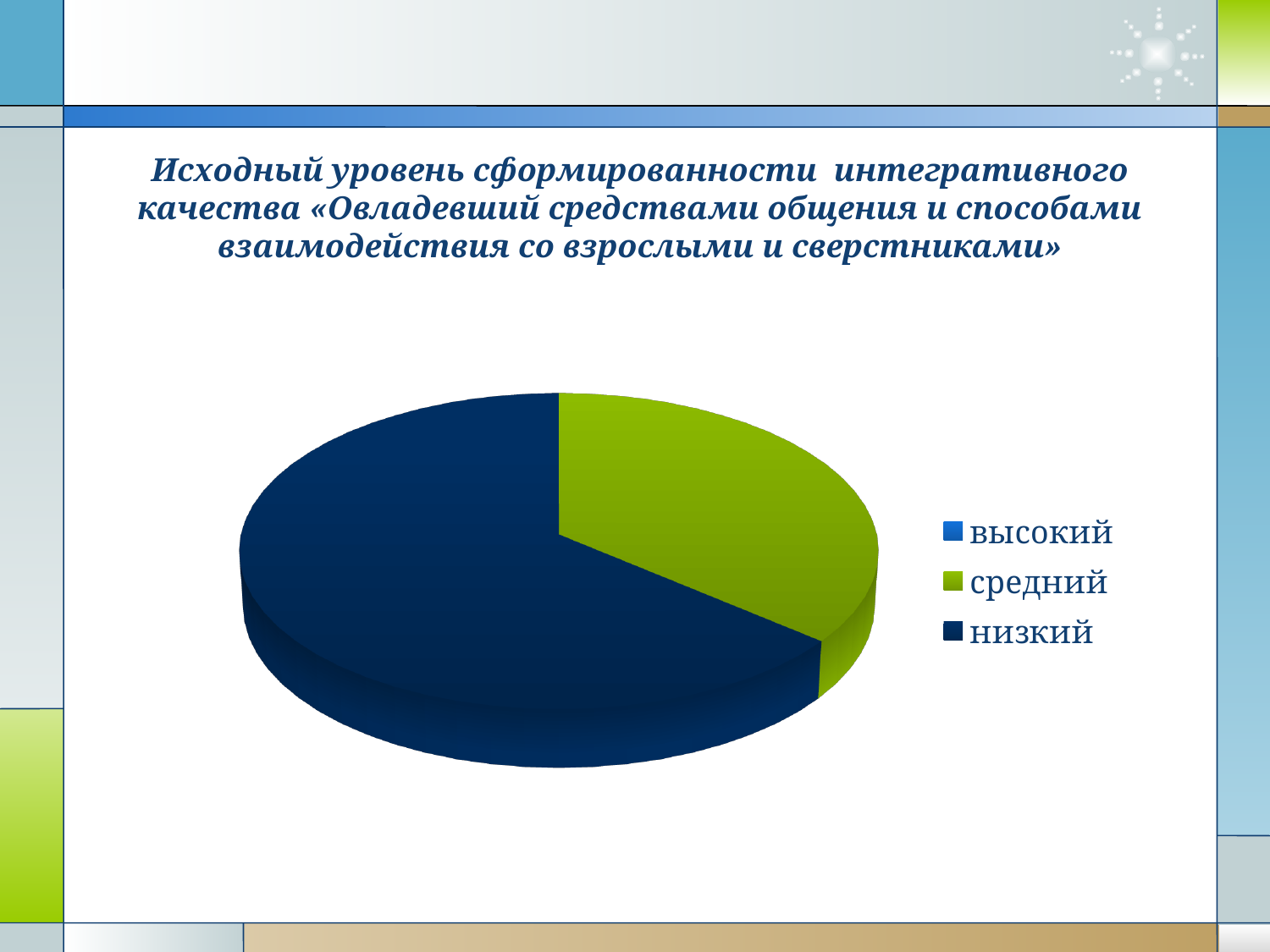
How many slices are visible in the pie? 2 Which is larger, the slice for низкий or the slice for средний? низкий Which category has the largest slice of the pie? низкий What colour is the slice for средний? green What kind of chart is shown on the slide? pie chart Which category is shown in dark navy blue in the legend? низкий Which legend category has no visible slice in the pie? высокий How many entries does the chart legend list? 3